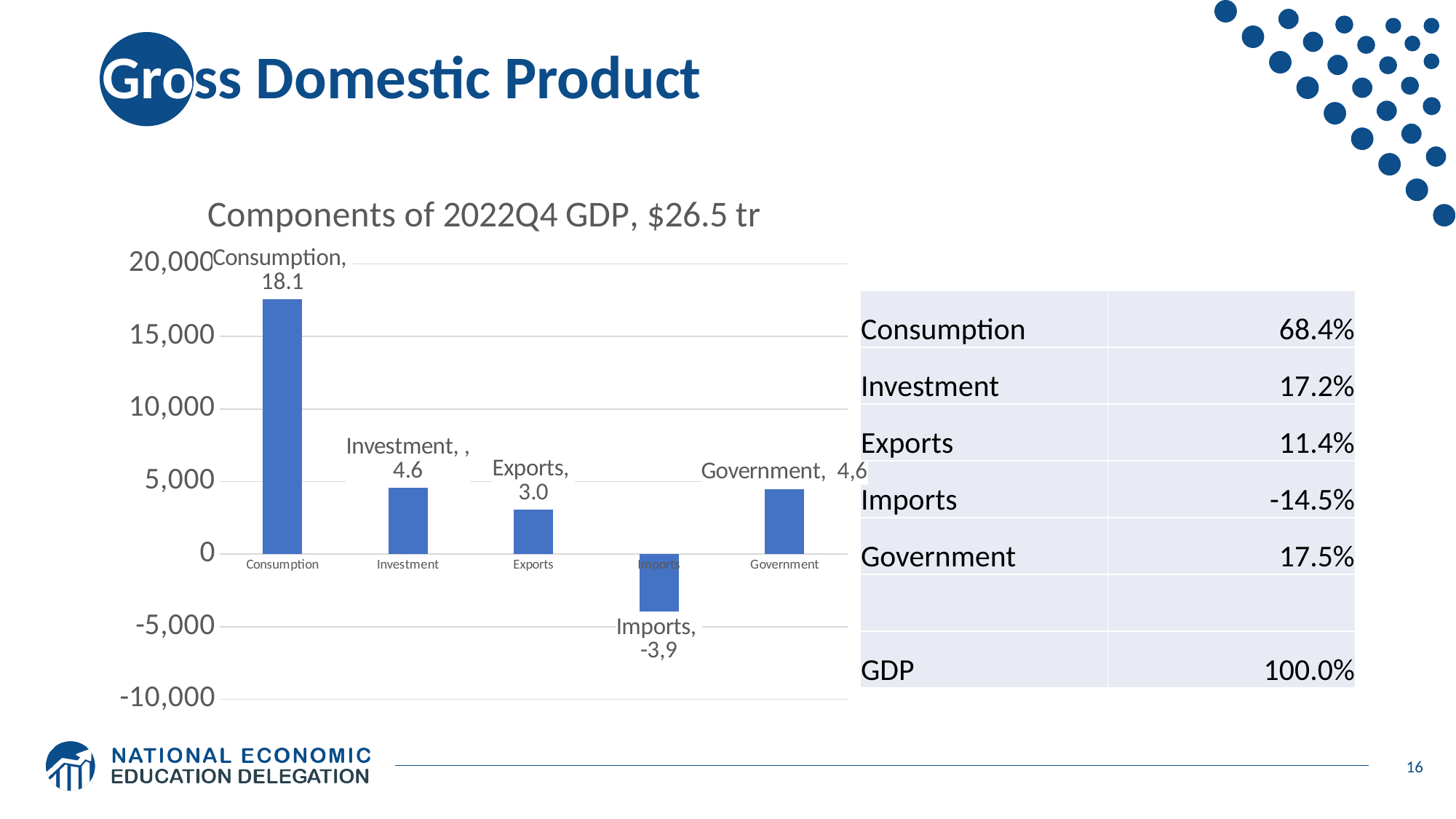
Which is larger, the bar for Consumption or the bar for Exports? Consumption What is the title of the chart? Components of 2022Q4 GDP, $26.5 tr What is the data label value for Exports in the chart? 3.0 What is the data label value for Imports in the chart? -3,9 What is the data label value for Investment in the chart? 4.6 What is the difference between the data label values for Consumption and Exports? 15.1 How many categories are shown on the x axis of the chart? 5 What is the data label value for Consumption in the chart? 18.1 Is the value for Consumption greater or less than 15,000 on the axis? greater Which category has the highest bar in the chart? Consumption Which category has the lowest bar in the chart? Imports Is the value for Imports greater or less than 0 on the axis? less